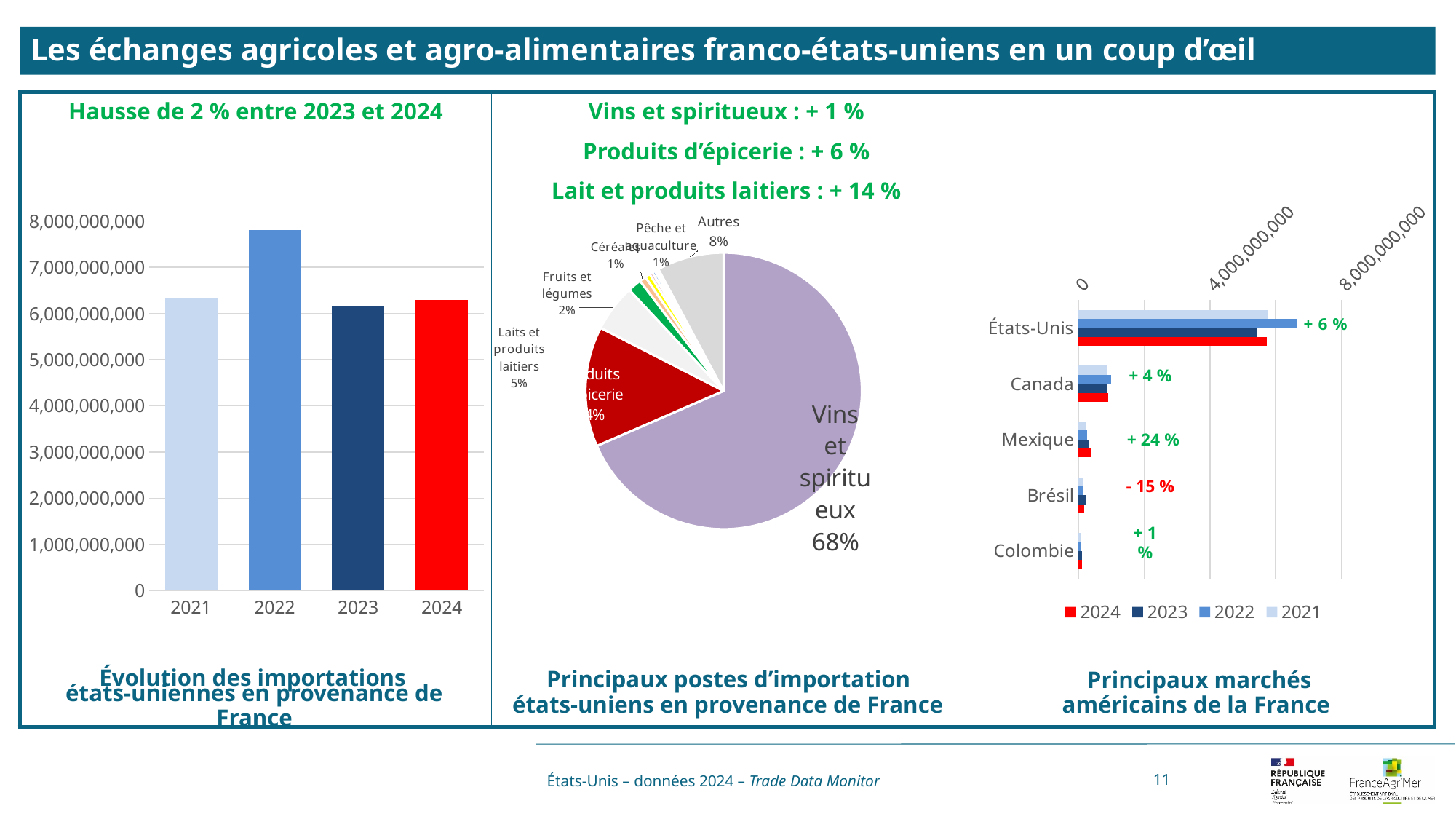
In the right chart 'Principaux marchés américains de la France', what percentage change is shown next to Mexique? + 24 % In the left chart 'Évolution des importations états-uniennes en provenance de France', which year has the highest value? 2022 In the middle pie chart 'Principaux postes d'importation états-uniens en provenance de France', what share does 'Laits et produits laitiers' have? 5% In the right chart 'Principaux marchés américains de la France', is the 2022 value for États-Unis greater or less than 4,000,000,000? greater In the left chart 'Évolution des importations états-uniennes en provenance de France', is the value for 2022 greater or less than 7,000,000,000? greater In the left chart 'Évolution des importations états-uniennes en provenance de France', which year has the lowest value? 2023 What kind of chart is the left chart titled 'Évolution des importations états-uniennes en provenance de France'? bar chart In the middle pie chart 'Principaux postes d'importation états-uniens en provenance de France', what share does 'Autres' have? 8% In the right chart 'Principaux marchés américains de la France', how many series does the legend list? 4 In the middle pie chart 'Principaux postes d'importation états-uniens en provenance de France', which slice is the largest? Vins et spiritueux In the left chart 'Évolution des importations états-uniennes en provenance de France', how many years are shown on the x axis? 4 In the middle pie chart 'Principaux postes d'importation états-uniens en provenance de France', what share does 'Vins et spiritueux' have? 68%